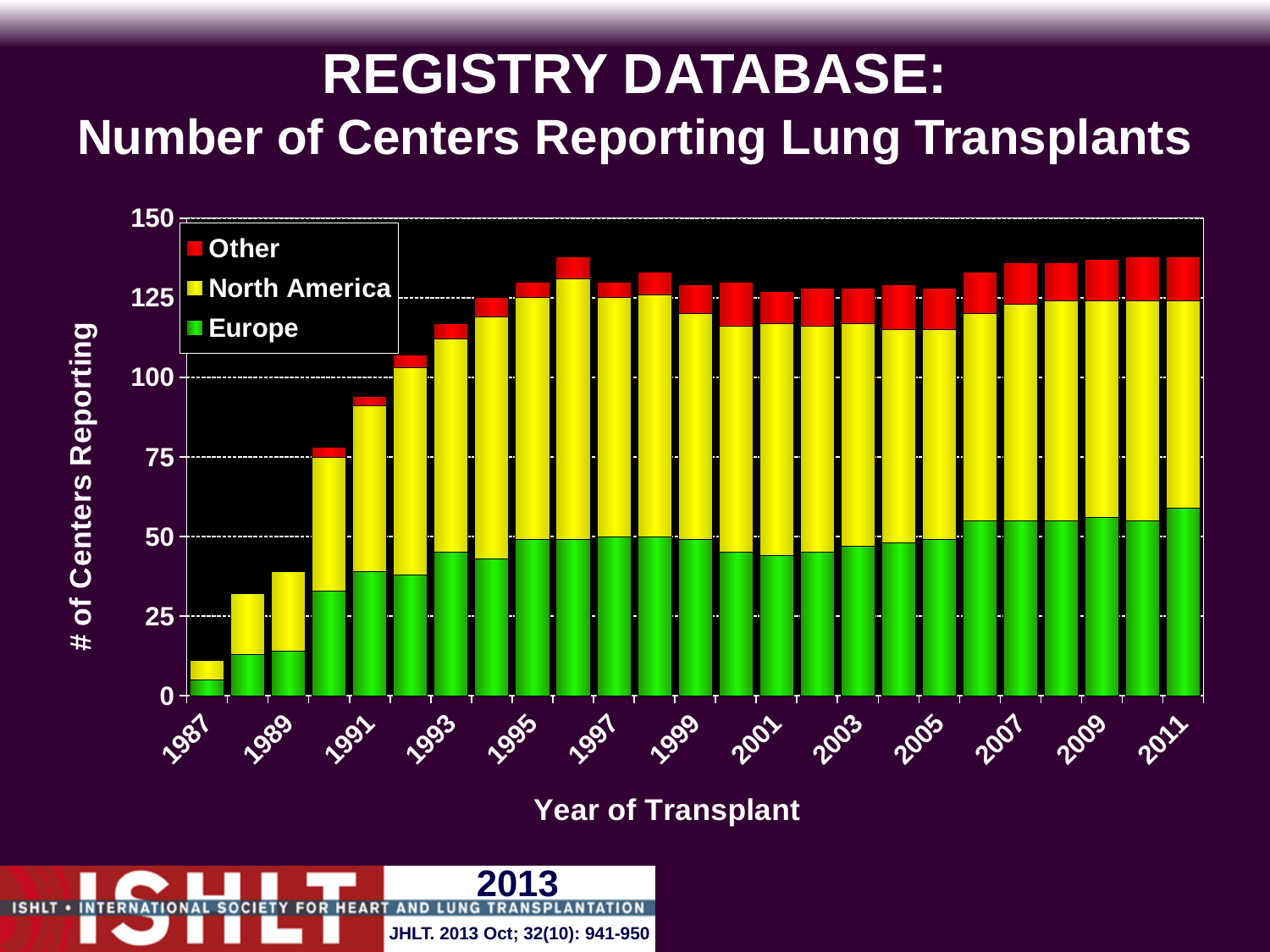
Is the total number of centers reporting in 1991 greater or less than 100? less Does the total number of centers reporting rise or fall from 1987 to 1996? rise How many years (bars) are plotted on the chart? 25 Is the total number of centers reporting in 1996 greater or less than 125? greater Which series are listed in the legend? Other, North America, Europe What kind of chart is shown on the slide? Stacked bar chart How many series does the legend list? 3 Is the total number of centers reporting in 1987 greater or less than 25? less Which year has a larger total number of centers reporting, 1987 or 1989? 1989 What is the label of the y axis? # of Centers Reporting Which year has the lowest total number of centers reporting? 1987